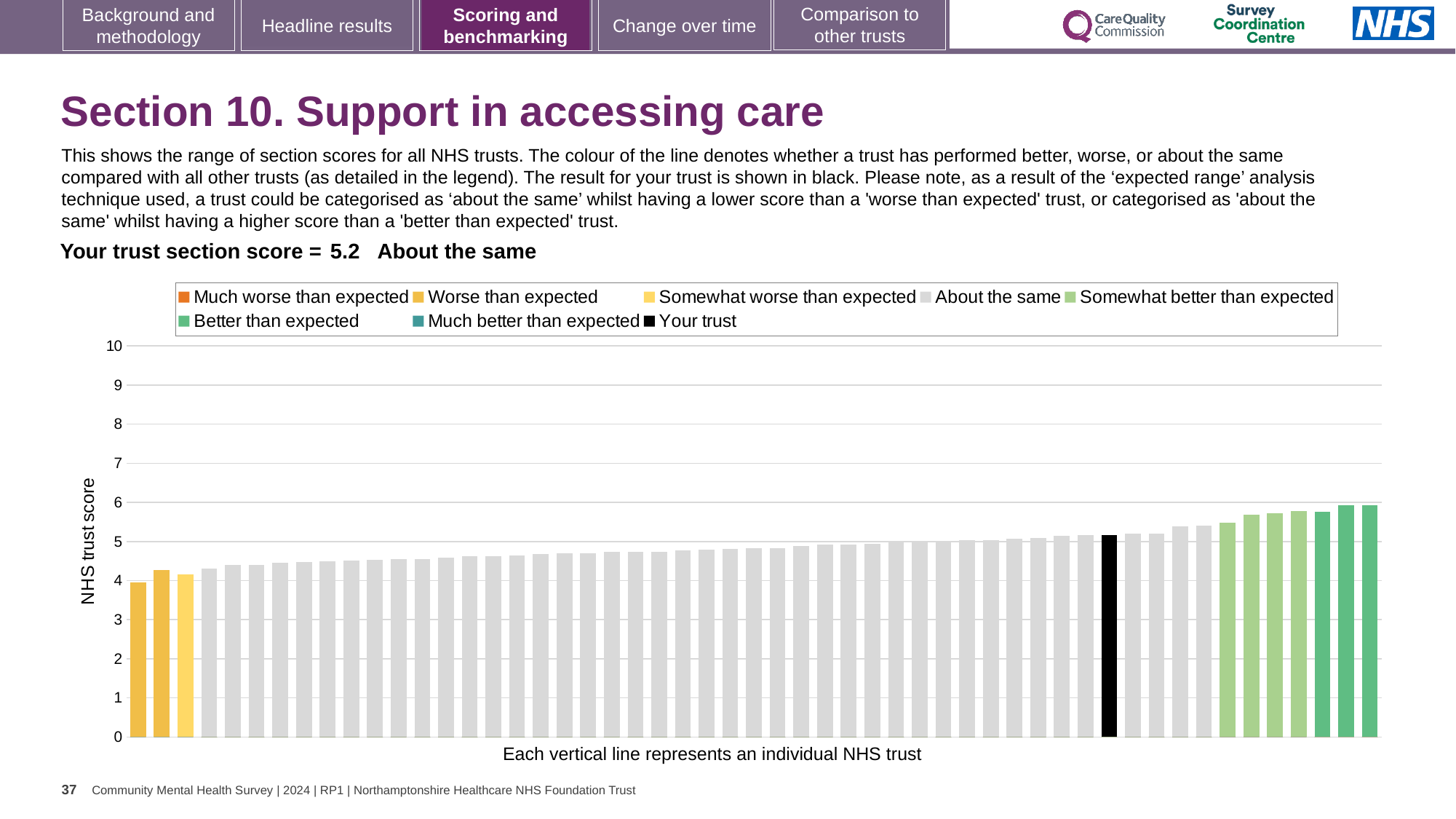
Is the value for your trust (the black bar) greater or less than 5? greater Do the bar values rise or fall from left to right along the x axis? rise Is the value of the rightmost bar greater or less than 5? greater How many bars are coloured black? 1 What type of chart is shown on the slide? bar chart What is the label on the vertical axis of the chart? NHS trust score What colour is used to show your trust in the chart? black Which performance category is your trust placed in for Section 10? About the same Is the value of the leftmost bar greater or less than 5? less What is the section score for your trust shown on the slide? 5.2 How many entries does the chart legend list? 8 How many bars are coloured in the yellow shades (the 'worse than expected' categories)? 3